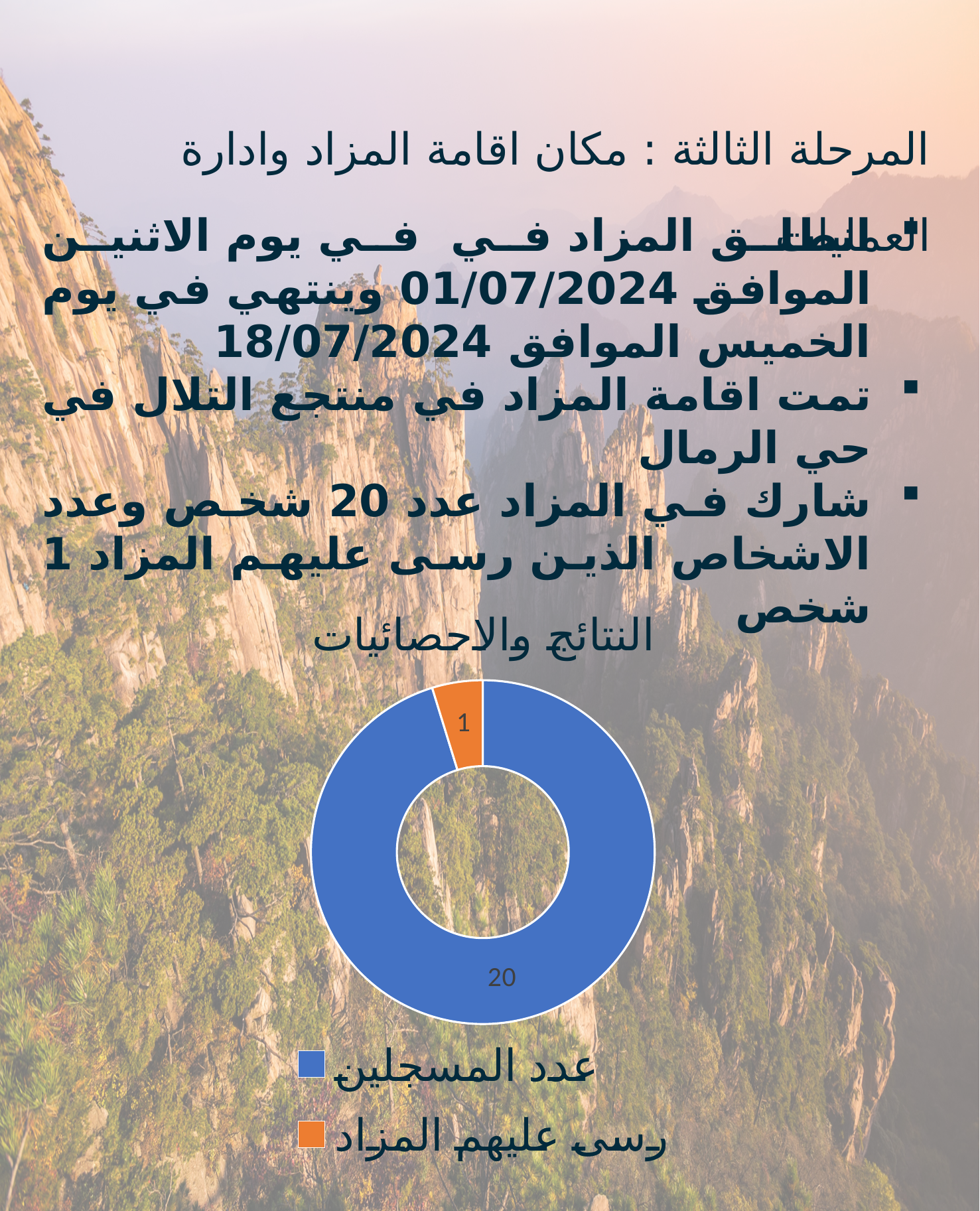
How many slices does the chart have? 2 What is the title of the chart? النتائج والاحصائيات Which category has the largest slice? عدد المسجلين What is the difference between the value for عدد المسجلين and the value for رسى عليهم المزاد? 19 What type of chart is shown on the slide? Doughnut (pie) chart Which is larger, عدد المسجلين or رسى عليهم المزاد? عدد المسجلين What colour is the slice for رسى عليهم المزاد? Orange Which category has the smallest slice? رسى عليهم المزاد What is the value for عدد المسجلين? 20 What is the total of all slices in the chart? 21 What is the value for رسى عليهم المزاد? 1 How many entries does the legend list? 2